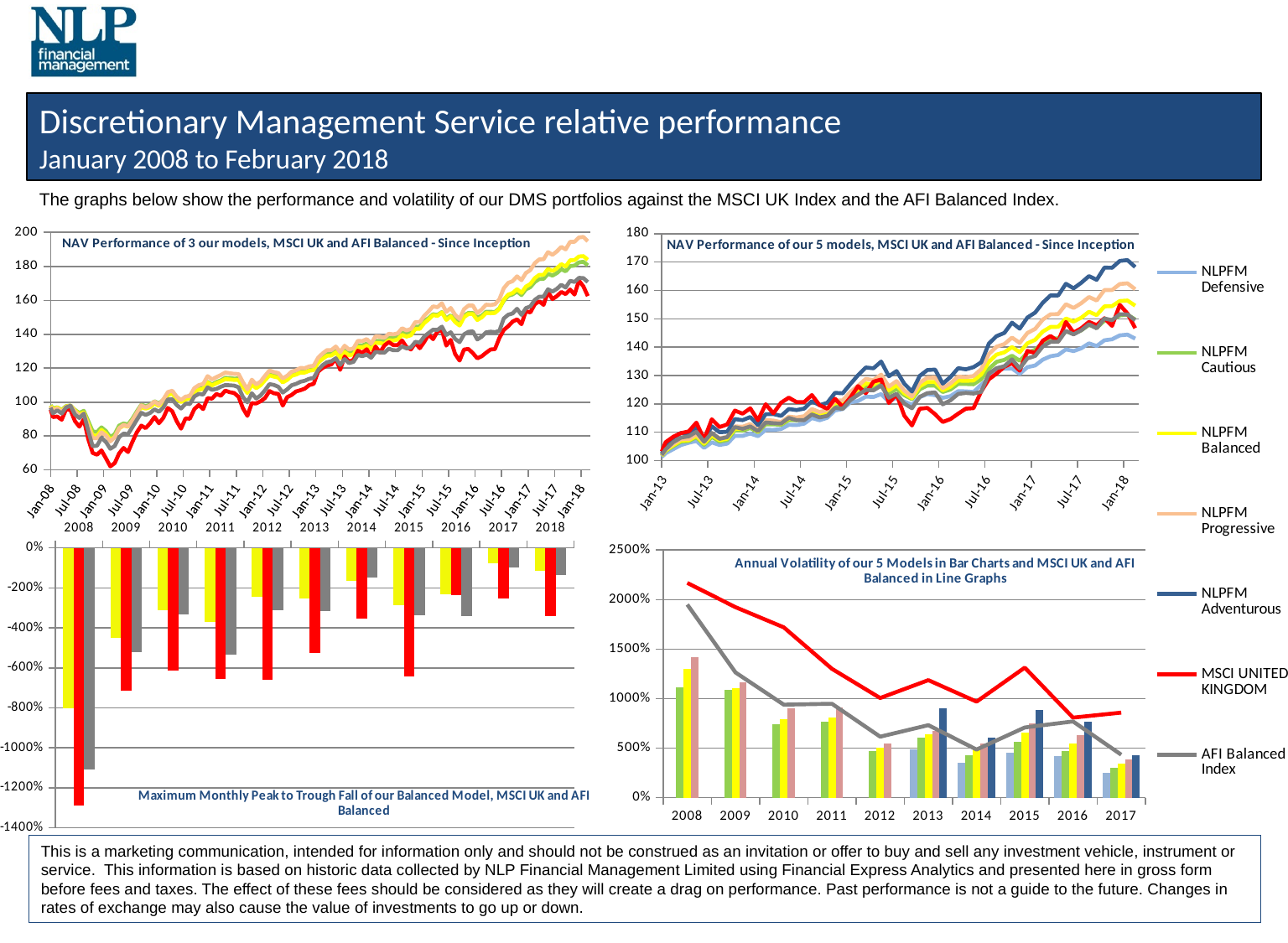
What is the title of the bottom-right chart on the slide? Annual Volatility of our 5 Models in Bar Charts and MSCI UK and AFI Balanced in Line Graphs What kind of chart is the top-left chart titled 'NAV Performance of 3 our models, MSCI UK and AFI Balanced - Since Inception'? line chart In the bottom-right chart 'Annual Volatility of our 5 Models', is the value for AFI Balanced Index in 2008 greater or less than 1500%? greater In the top-right chart 'NAV Performance of our 5 models', does the NLPFM Adventurous line rise or fall from Jan-13 to Jan-18? rise In the bottom-right chart 'Annual Volatility of our 5 Models', which series has the highest volatility in 2008? MSCI UNITED KINGDOM In the bottom-left chart 'Maximum Monthly Peak to Trough Fall', how many years are shown on the x axis? 11 How many series does the legend on the right of the slide list? 7 What kind of chart is the bottom-left chart titled 'Maximum Monthly Peak to Trough Fall of our Balanced Model, MSCI UK and AFI Balanced'? bar chart In the bottom-right chart 'Annual Volatility of our 5 Models', how many years are shown on the x axis? 10 In the top-right chart 'NAV Performance of our 5 models', is the value for NLPFM Adventurous at Jan-18 greater or less than 160? greater In the bottom-left chart 'Maximum Monthly Peak to Trough Fall', is the value of the red MSCI UK bar for 2008 greater or less than -1200%? less In the top-right chart 'NAV Performance of our 5 models', which is larger at Jan-18: NLPFM Adventurous or NLPFM Defensive? NLPFM Adventurous